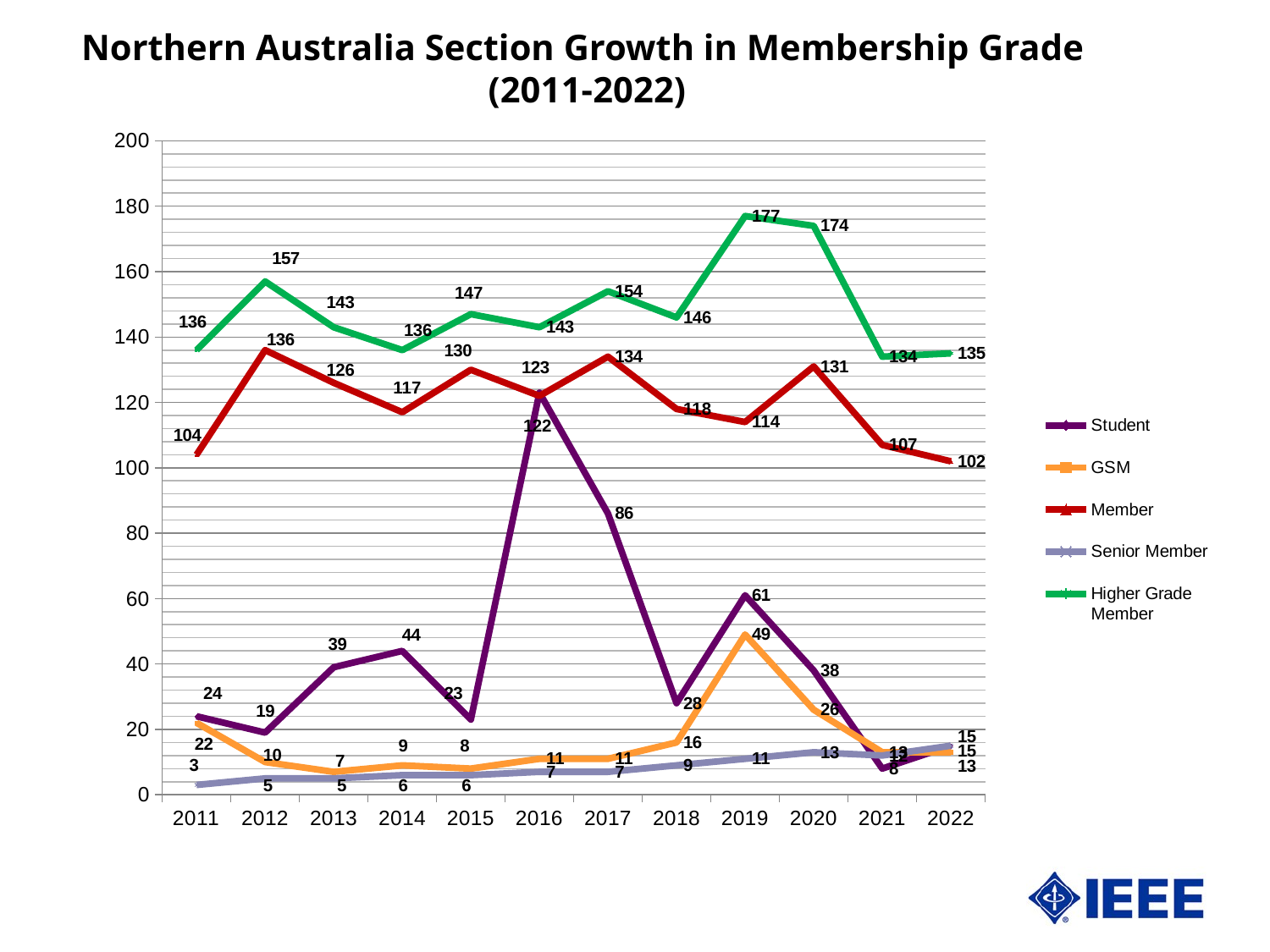
In which year is the Member series at its lowest? 2022 What is the value for Higher Grade Member in 2019? 177 What is the difference between the Higher Grade Member values for 2019 and 2020? 3 How many series does the legend list? 5 What is the value for Member in 2011? 104 What kind of chart is shown on the slide? Line chart In which year is the Higher Grade Member series at its highest? 2019 What is the value for Senior Member in 2011? 3 In 2014, which is larger: the Student value or the GSM value? Student What is the value for GSM in 2019? 49 What is the value for Student in 2016? 123 Does the Member series rise or fall from 2020 to 2022? Fall